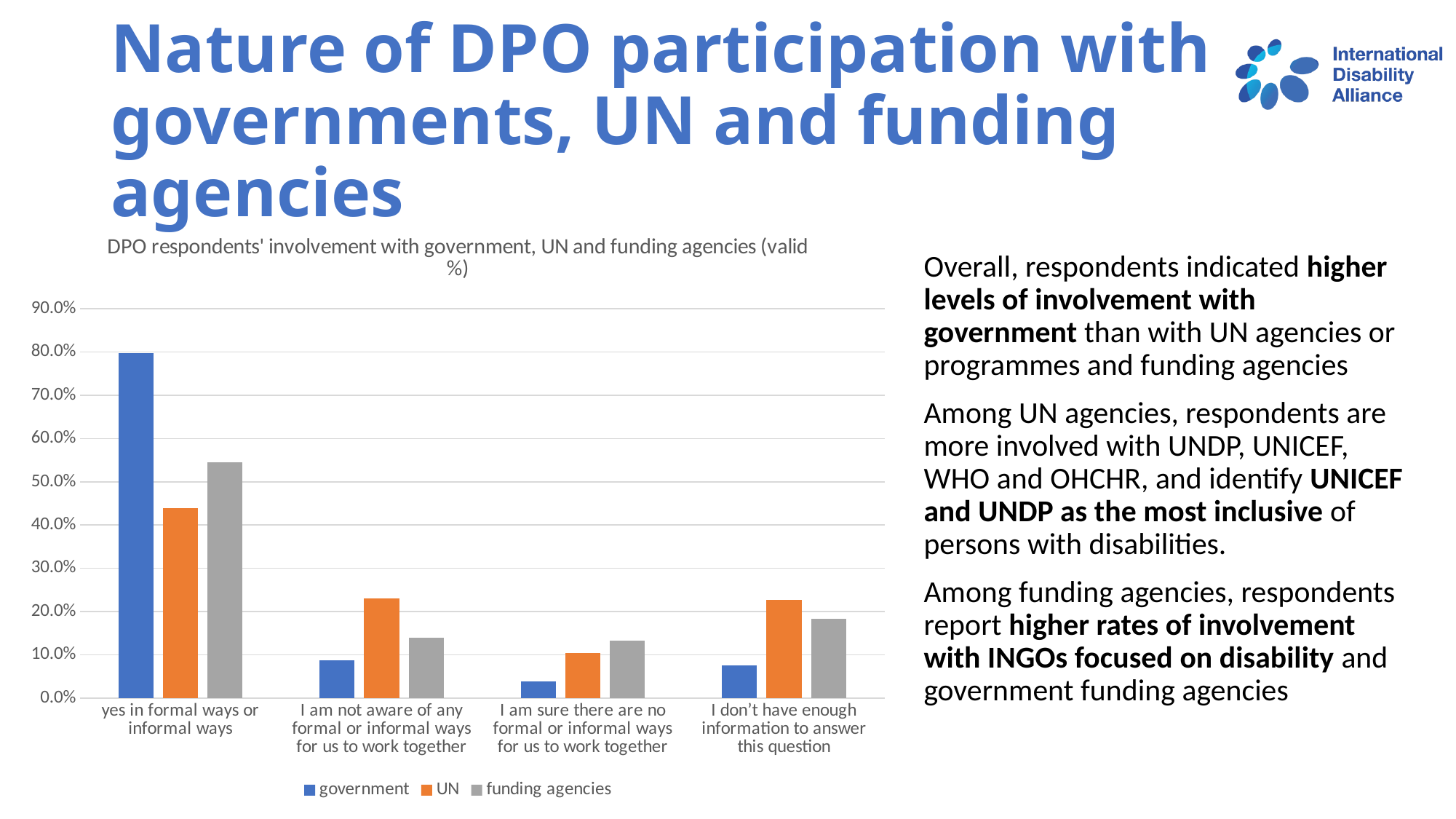
Which series has the highest value for 'I am not aware of any formal or informal ways for us to work together'? UN Which series has the lowest value for 'I am sure there are no formal or informal ways for us to work together'? government What colour are the bars for the UN series? orange For 'I don't have enough information to answer this question', which is larger: the UN value or the funding agencies value? UN Is the UN value for 'yes in formal ways or informal ways' greater or less than 50.0%? less Is the government value for 'I am sure there are no formal or informal ways for us to work together' greater or less than 10.0%? less Is the funding agencies value for 'yes in formal ways or informal ways' greater or less than 50.0%? greater Which series has the highest value for 'yes in formal ways or informal ways'? government How many series does the legend list? 3 What kind of chart is shown on the slide? bar chart How many categories are shown on the x axis? 4